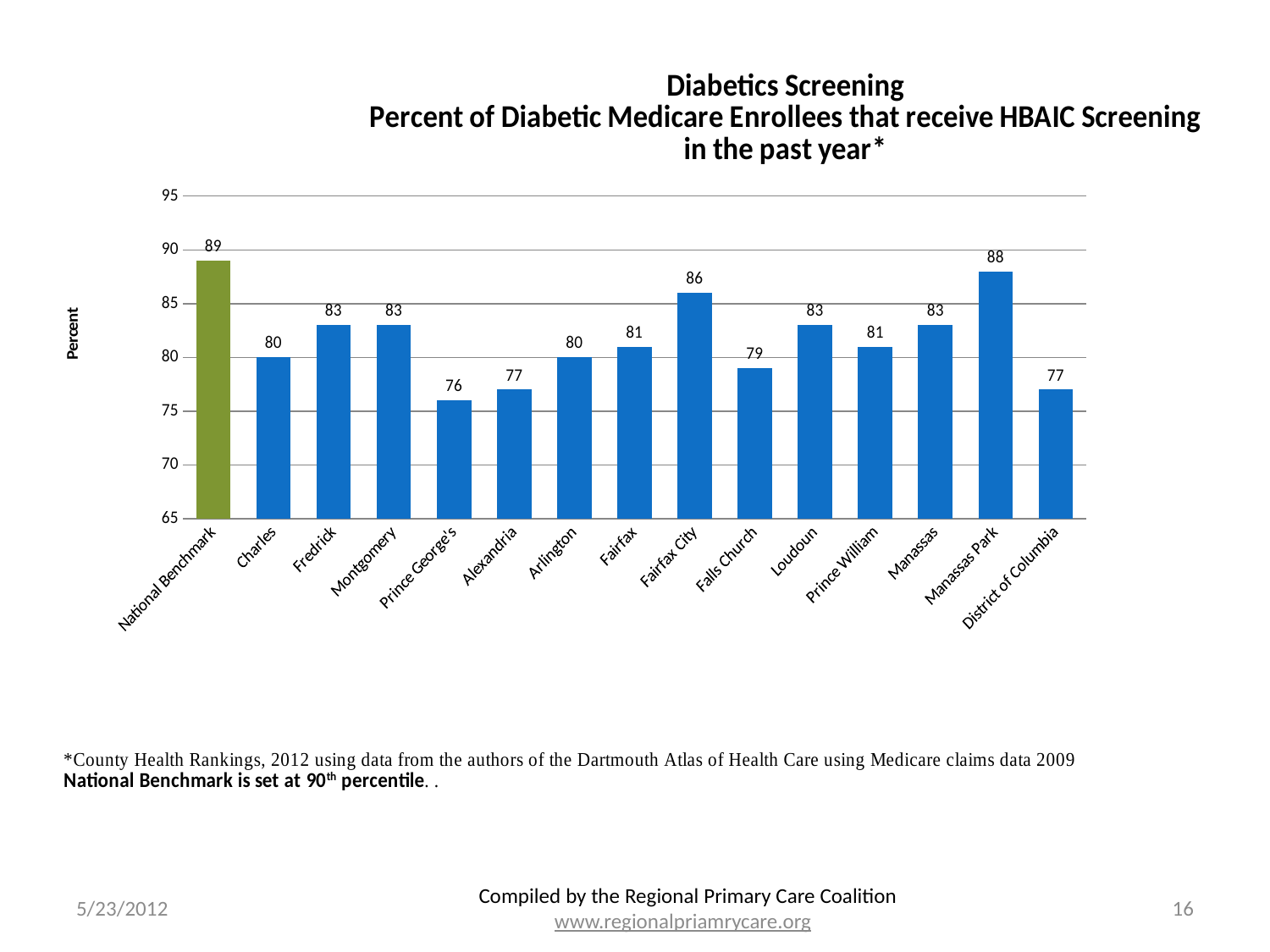
How many categories are shown on the x axis? 15 What is the difference between Fairfax City and Falls Church? 7 What is the value for the National Benchmark? 89 Which category has the lowest value? Prince George's What is the value for Fairfax City? 86 What kind of chart is shown on the slide? bar chart Which category has the highest value? National Benchmark Is the value for Alexandria greater or less than 80? less What is the label of the y axis? Percent What is the difference between the National Benchmark and Manassas Park? 1 What is the value for Prince George's? 76 Which is larger, the value for Loudoun or the value for Charles? Loudoun